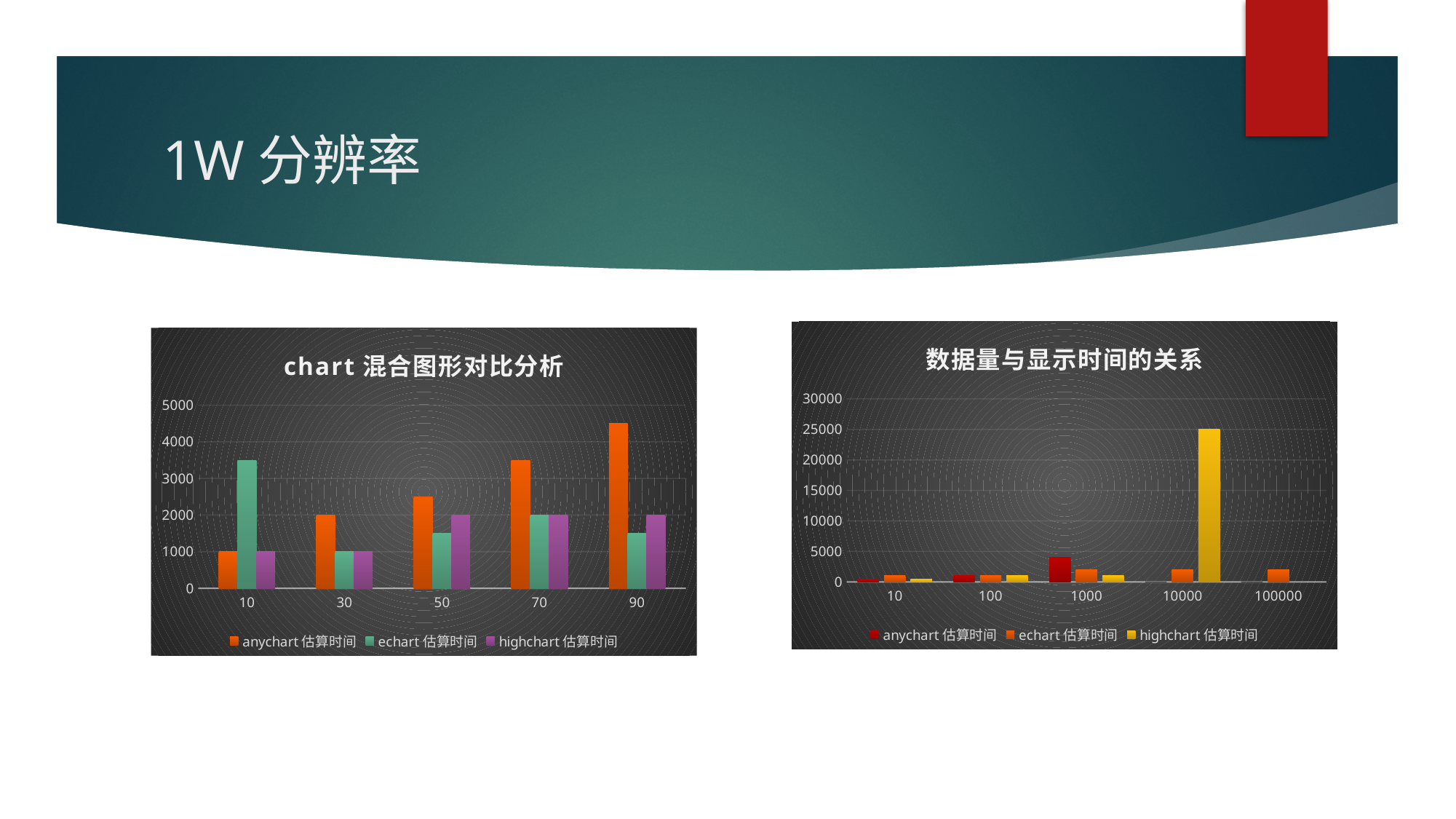
In the right chart "数据量与显示时间的关系", at which category is the highchart 估算时间 bar highest? 10000 What is the title of the right chart? 数据量与显示时间的关系 What kind of chart is the left chart titled "chart 混合图形对比分析"? bar chart In the left chart "chart 混合图形对比分析", at category 10, which is larger: anychart 估算时间 or echart 估算时间? echart 估算时间 In the left chart "chart 混合图形对比分析", does the anychart 估算时间 series rise or fall from category 10 to category 90? rise In the right chart "数据量与显示时间的关系", how many categories are shown on the x axis? 5 In the right chart "数据量与显示时间的关系", what is the value of highchart 估算时间 at category 10000? 25000 In the left chart "chart 混合图形对比分析", is the value of anychart 估算时间 at category 90 greater or less than 4000? greater In the left chart "chart 混合图形对比分析", how many series does the legend list? 3 In the left chart "chart 混合图形对比分析", how many categories are shown on the x axis? 5 In the left chart "chart 混合图形对比分析", what is the value of anychart 估算时间 at category 30? 2000 In the left chart "chart 混合图形对比分析", at which category is the anychart 估算时间 bar highest? 90